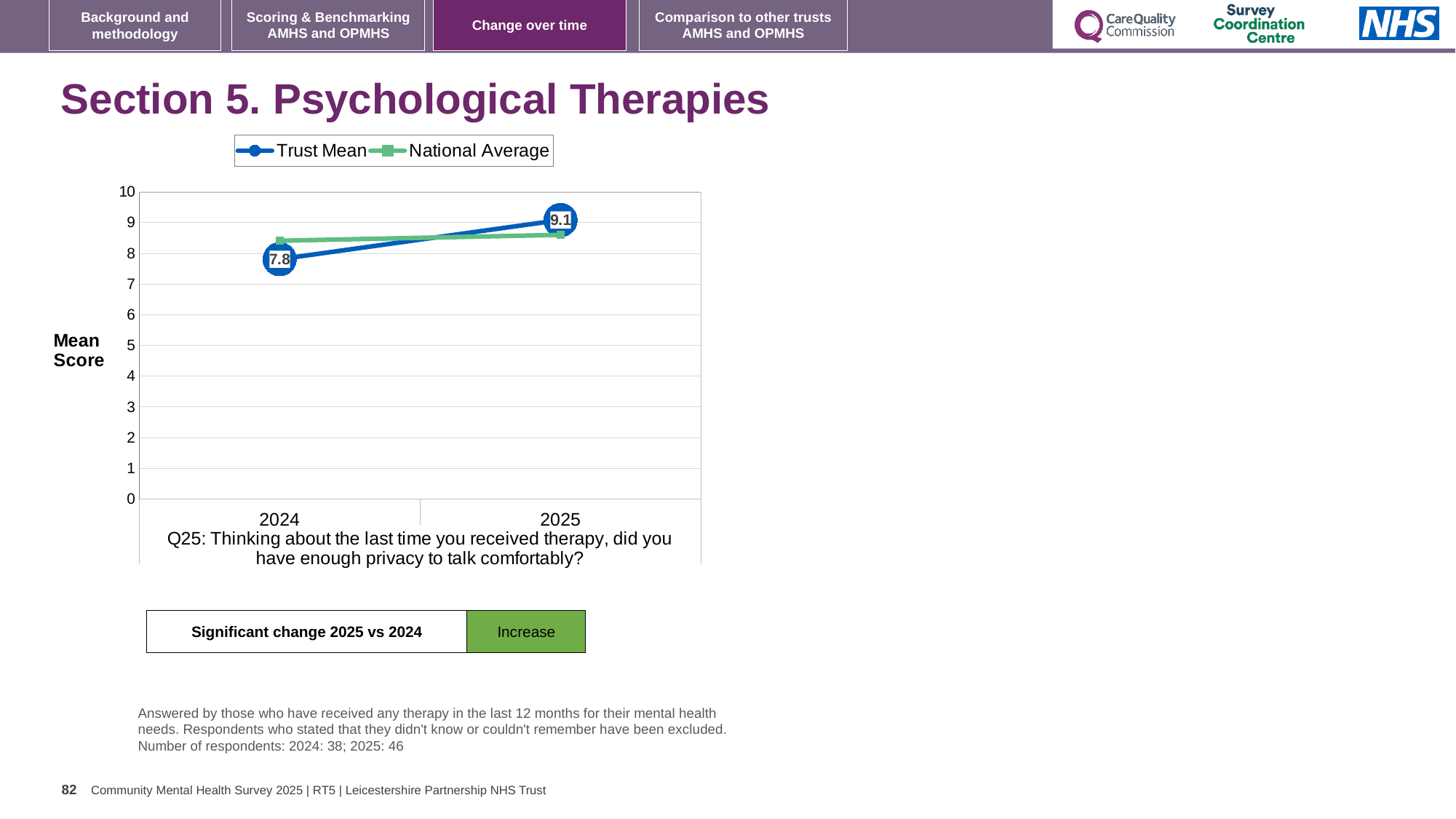
In which year is the Trust Mean higher? 2025 How many series does the legend list? 2 Is the National Average for 2024 greater or less than 8? greater By how much did the Trust Mean change from 2024 to 2025? 1.3 In 2025, which is higher: the Trust Mean or the National Average? Trust Mean In 2024, which is higher: the Trust Mean or the National Average? National Average What is the Trust Mean score for 2025? 9.1 What type of chart is shown on the slide? line chart What is the Trust Mean score for 2024? 7.8 Is the National Average for 2025 greater or less than 9? less Does the Trust Mean rise or fall from 2024 to 2025? rise What is the label of the y axis? Mean Score